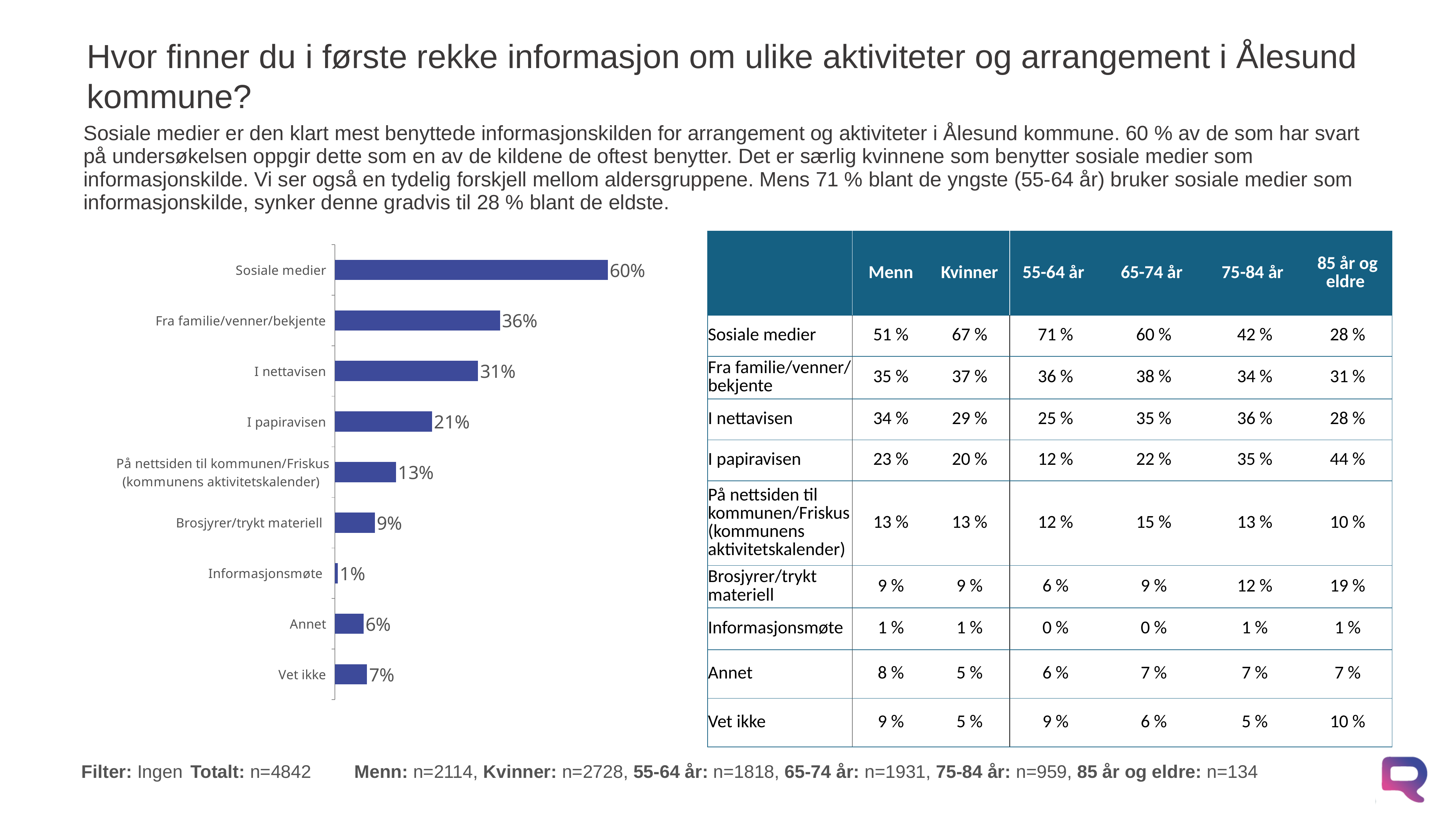
What is the value for På nettsiden til kommunen/Friskus (kommunens aktivitetskalender) in the bar chart? 13% Which category has the highest value in the bar chart? Sosiale medier What is the difference between the values for I nettavisen and I papiravisen in the bar chart? 10% Which is larger in the bar chart: Annet or Vet ikke? Vet ikke What is the difference between the values for Sosiale medier and Fra familie/venner/bekjente in the bar chart? 24% Which category has the lowest value in the bar chart? Informasjonsmøte Which is larger in the bar chart: Brosjyrer/trykt materiell or På nettsiden til kommunen/Friskus (kommunens aktivitetskalender)? På nettsiden til kommunen/Friskus (kommunens aktivitetskalender) What kind of chart is shown on the slide? Bar chart What is the value for I nettavisen in the bar chart? 31% What is the value for Sosiale medier in the bar chart? 60% What is the value for Vet ikke in the bar chart? 7% How many categories are shown in the bar chart? 9